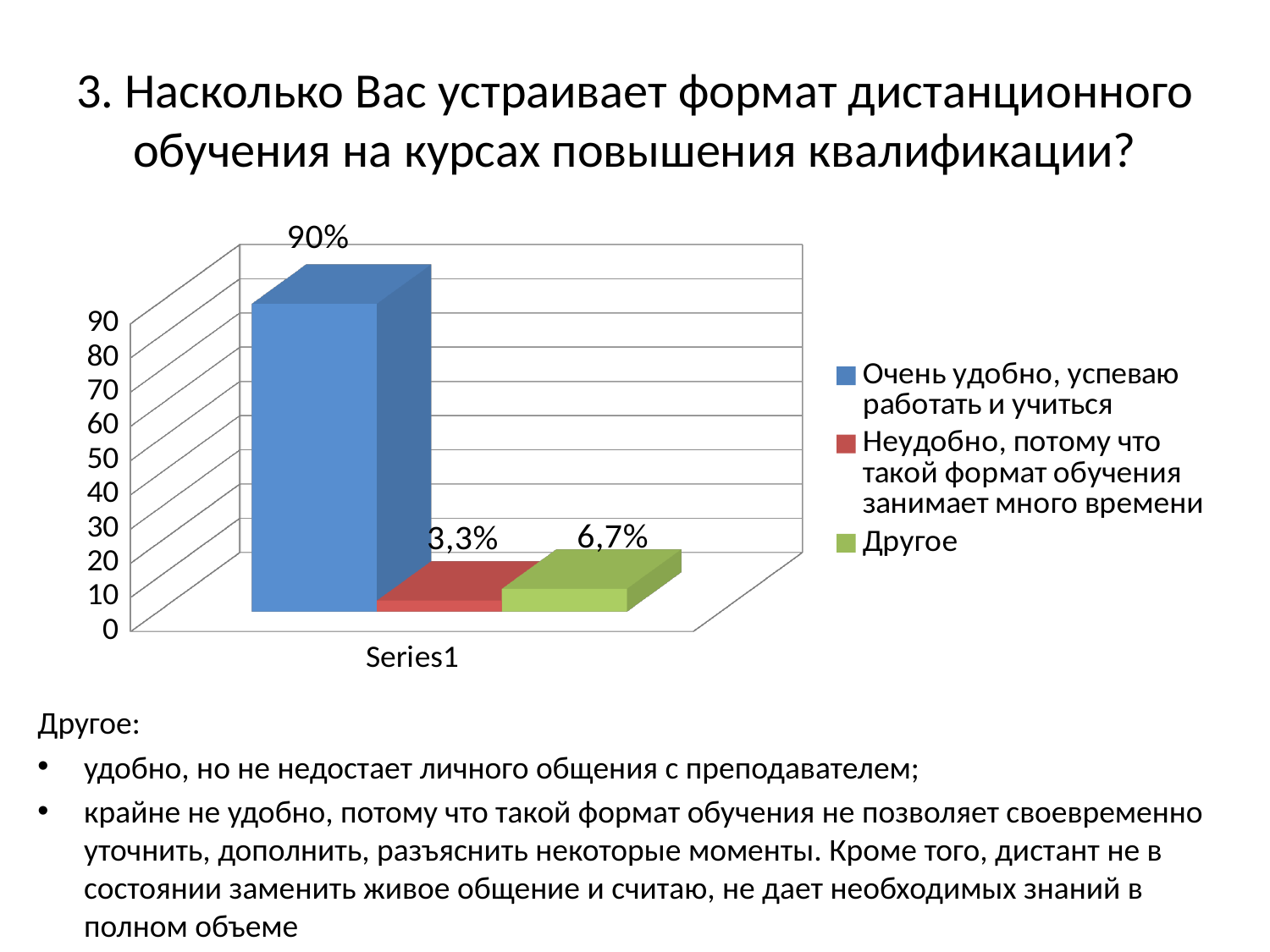
What colour is the bar for "Другое"? green Which response option has the highest value? Очень удобно, успеваю работать и учиться Is the value for "Очень удобно, успеваю работать и учиться" greater or less than 80? greater What value is shown for "Очень удобно, успеваю работать и учиться"? 90% What value is shown for "Неудобно, потому что такой формат обучения занимает много времени"? 3,3% Which response option has the lowest value? Неудобно, потому что такой формат обучения занимает много времени Which is larger: the value for "Другое" or the value for "Неудобно, потому что такой формат обучения занимает много времени"? Другое What is the difference between the values for "Другое" and "Неудобно, потому что такой формат обучения занимает много времени"? 3,4% What is the difference between the values for "Очень удобно, успеваю работать и учиться" and "Другое"? 83,3% What kind of chart is shown on the slide? bar chart What value is shown for "Другое"? 6,7% How many series does the legend list? 3